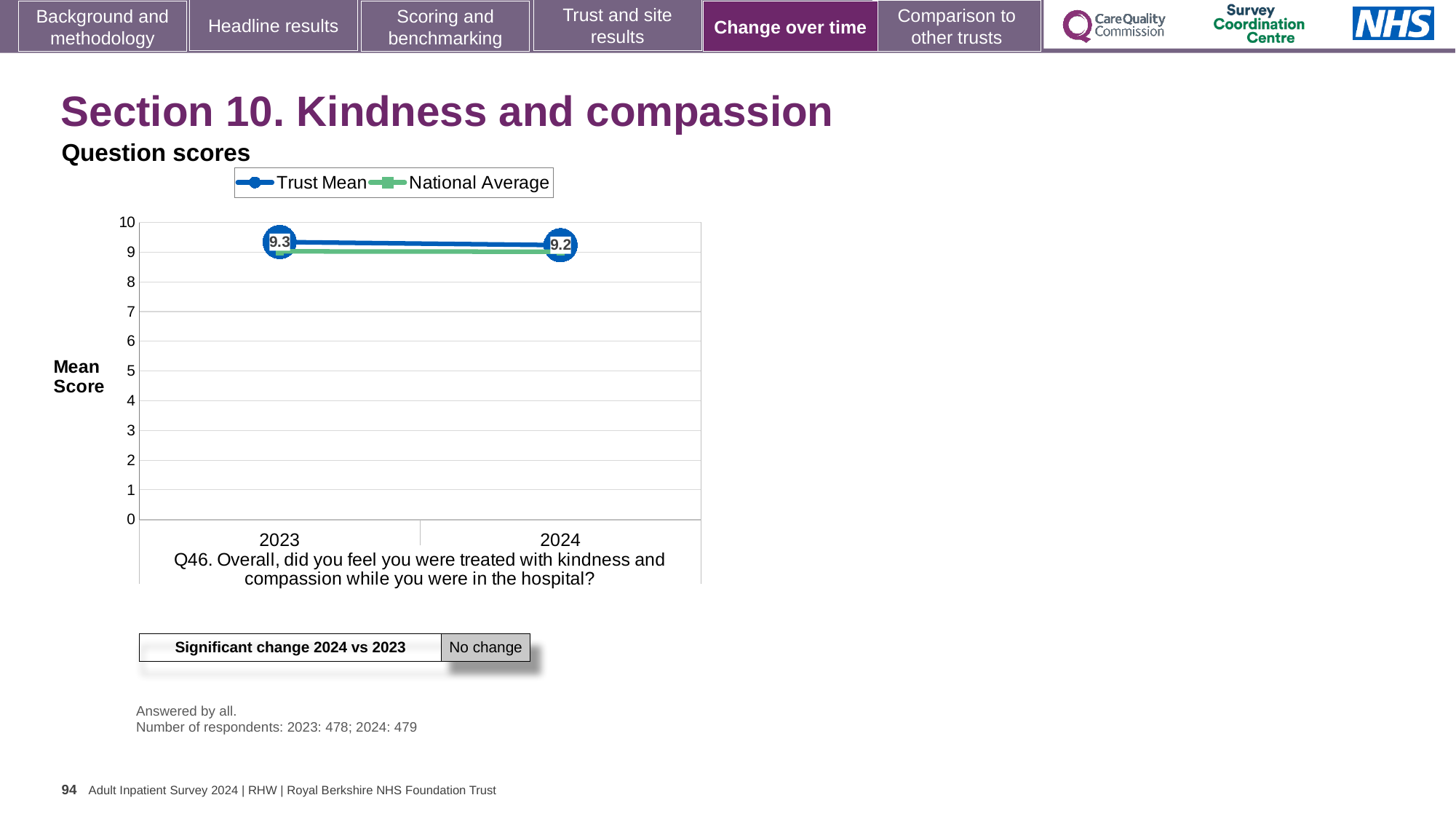
How many years are plotted on the x axis? 2 Is the National Average value for 2024 greater or less than 8? greater What kind of chart is shown on the slide? line chart What is the Trust Mean score for 2023? 9.3 Does the Trust Mean rise or fall from 2023 to 2024? fall How many series does the legend list? 2 What is the Trust Mean score for 2024? 9.2 What is the difference between the Trust Mean scores for 2023 and 2024? 0.1 What are the two series named in the legend? Trust Mean and National Average Is the Trust Mean value for 2023 greater or less than 9? greater What is the label on the y axis of the chart? Mean Score In which year is the Trust Mean score higher, 2023 or 2024? 2023